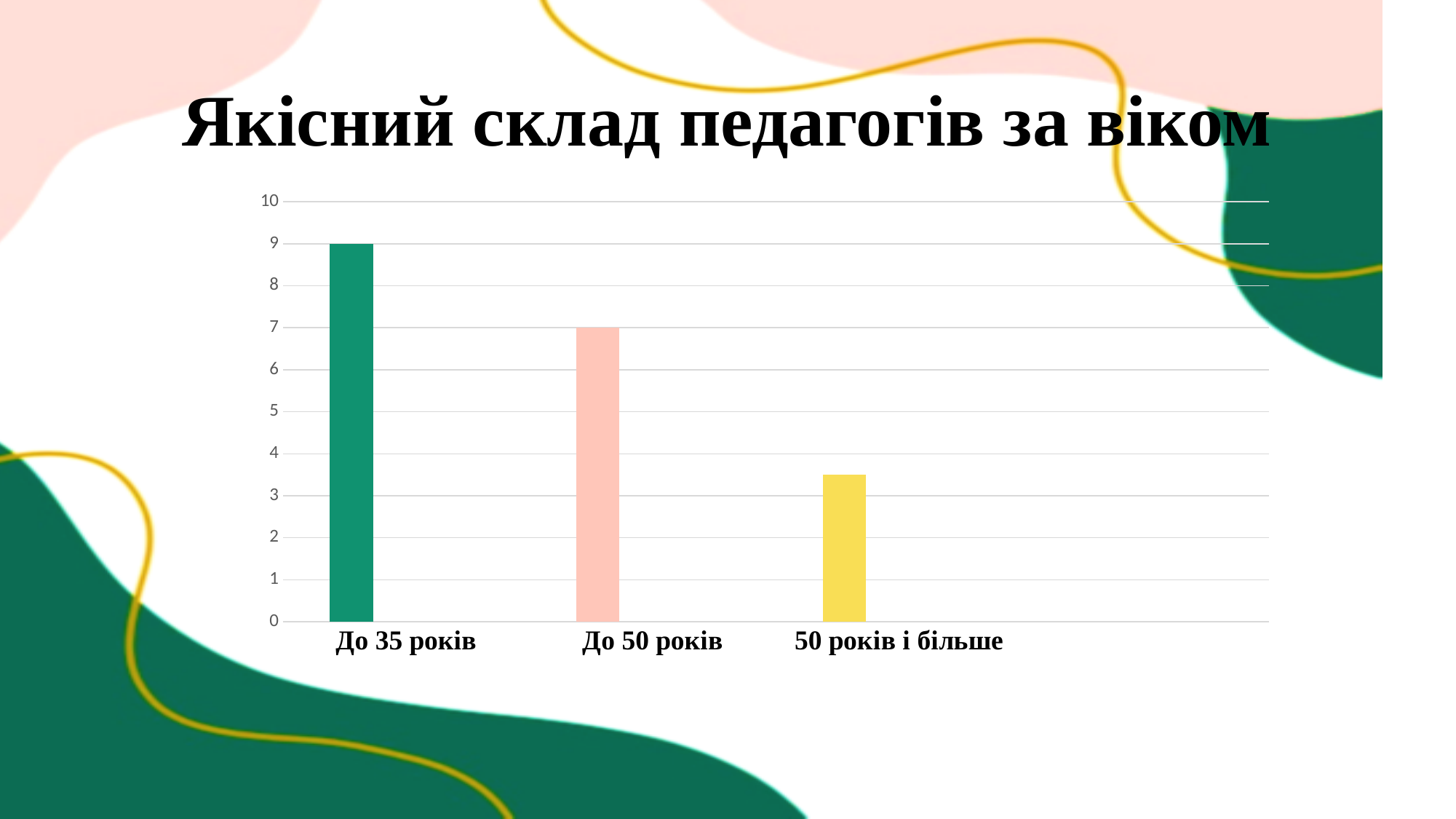
What is the difference between the values for "До 35 років" and "До 50 років"? 2 How many categories are shown on the x axis? 3 Is the value for "50 років і більше" greater or less than 3? greater What is the value for "До 50 років"? 7 Is the value for "50 років і більше" greater or less than 4? less What is the title of the slide? Якісний склад педагогів за віком Which category has the lowest value? 50 років і більше What is the value for "До 35 років"? 9 Which is larger, the value for "До 50 років" or the value for "50 років і більше"? До 50 років Do the values rise or fall from left to right along the x axis? fall What kind of chart is shown on the slide? bar chart Which category has the highest value? До 35 років